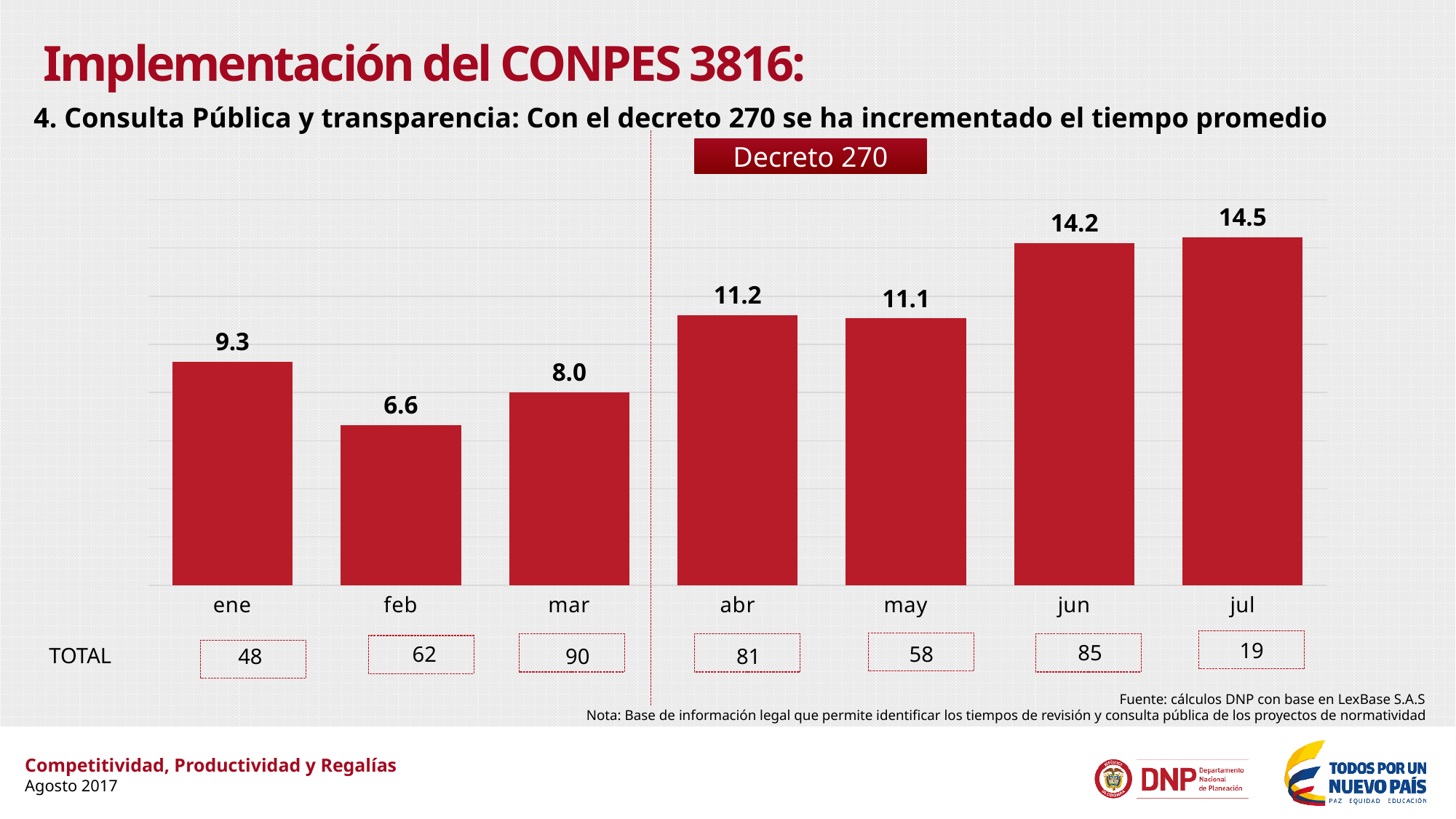
Which month has the lowest value? feb What is the difference between the values for mar and feb? 1.4 Which month has the highest value? jul Do the values generally rise or fall from ene to jul? rise What is the value for ene? 9.3 What kind of chart is shown? bar chart Which is larger, the value for abr or the value for mar? abr What is the TOTAL shown below the bar for mar? 90 What label appears in the box above the dashed vertical line? Decreto 270 What is the difference between the values for jul and ene? 5.2 How many months are shown on the x axis? 7 What is the value for may? 11.1